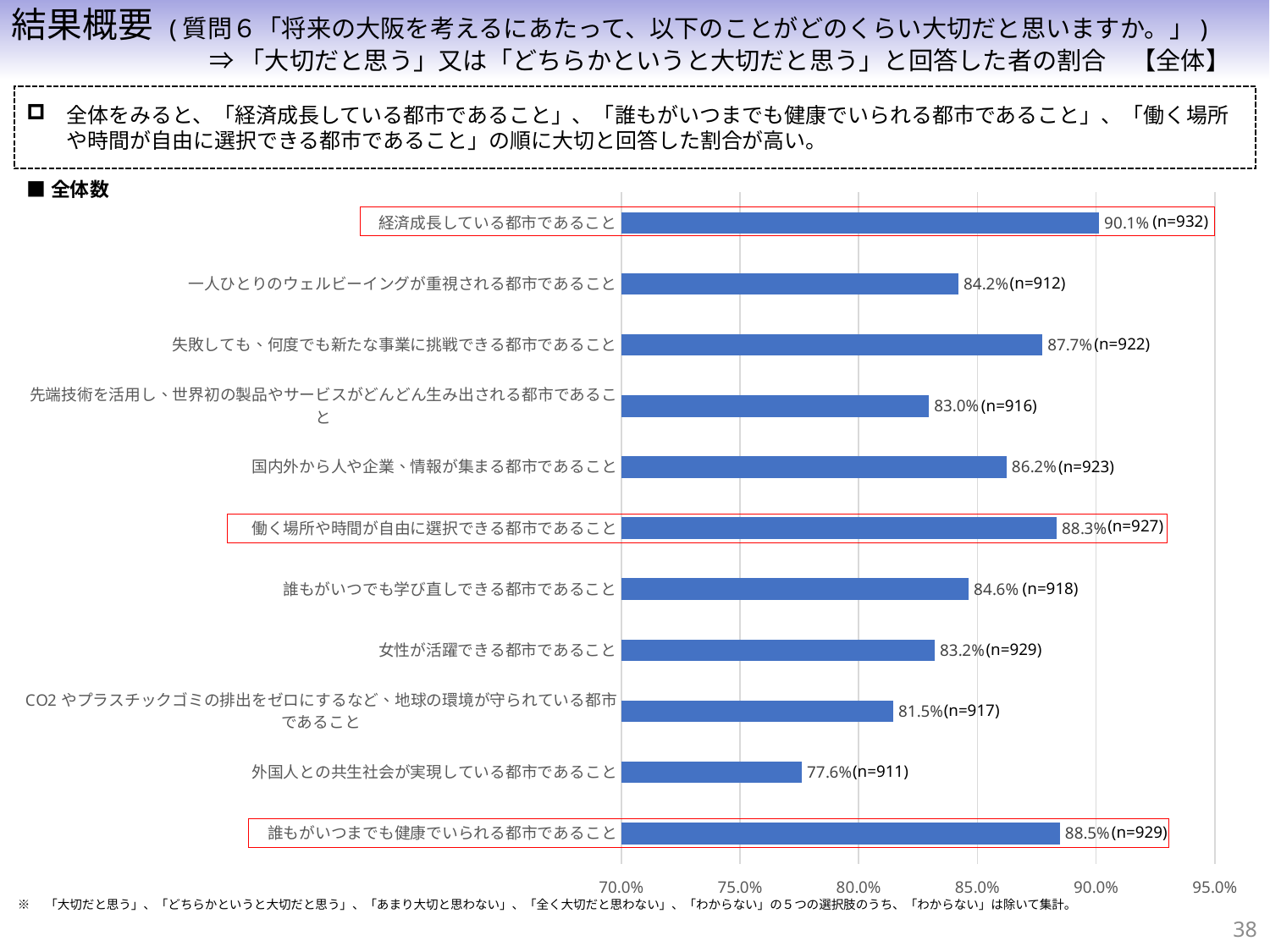
What is the value for 働く場所や時間が自由に選択できる都市であること? 88.3% Is the value for 外国人との共生社会が実現している都市であること greater or less than 80.0%? less What is the difference between the highest value (経済成長している都市であること) and the lowest value (外国人との共生社会が実現している都市であること)? 12.5 percentage points What kind of chart is shown on the slide? bar chart Which is larger: the value for 国内外から人や企業、情報が集まる都市であること or the value for 先端技術を活用し、世界初の製品やサービスがどんどん生み出される都市であること? 国内外から人や企業、情報が集まる都市であること What is the sample size (n) shown for 女性が活躍できる都市であること? n=929 Which category has the highest value? 経済成長している都市であること What is the value for 経済成長している都市であること? 90.1% What is the value for 外国人との共生社会が実現している都市であること? 77.6% Which category has the lowest value? 外国人との共生社会が実現している都市であること How many categories are plotted in the bar chart? 11 What is the value at the left end of the horizontal axis? 70.0%